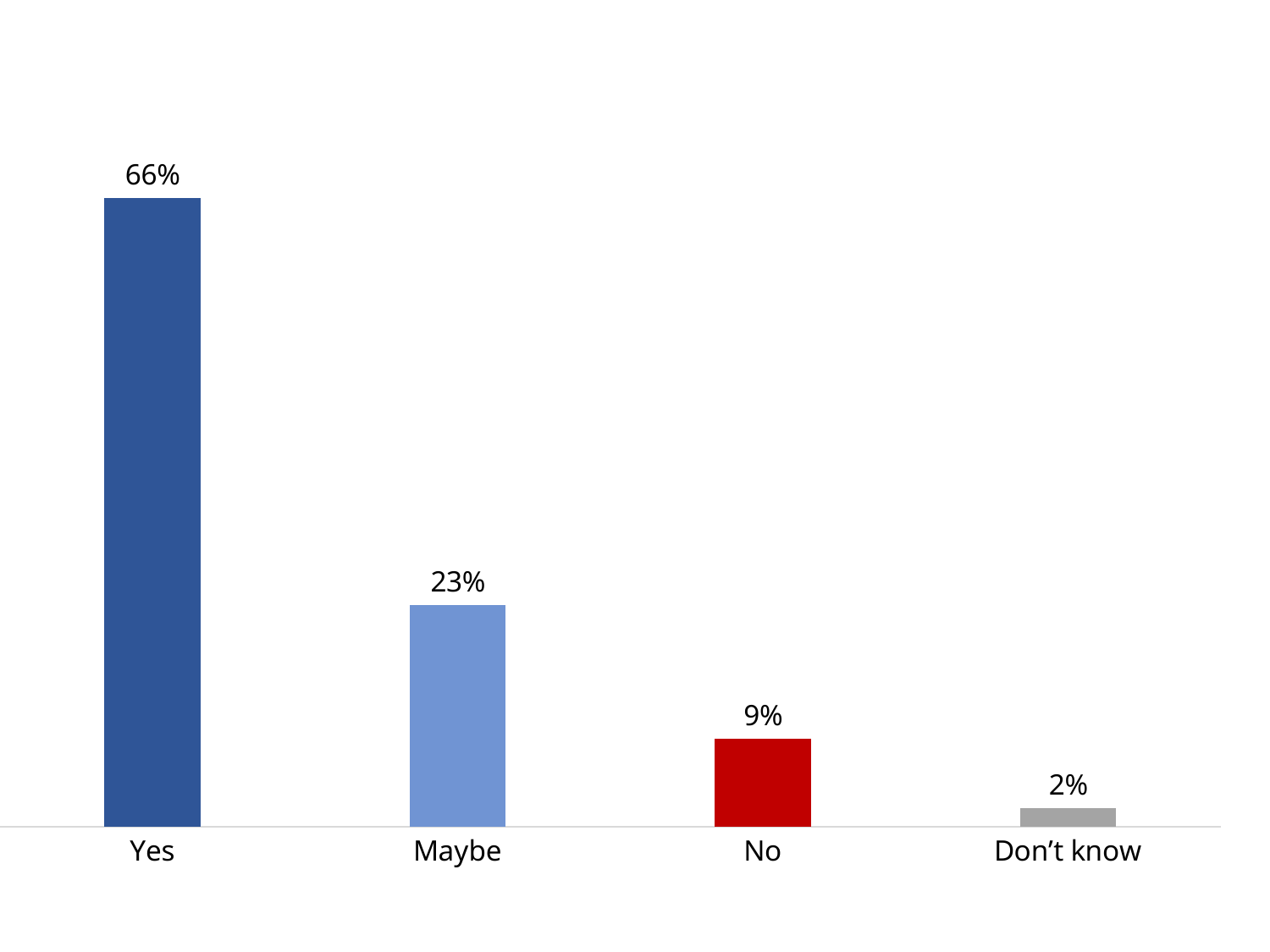
What is the difference between the values for No and Don't know? 7% What is the value for No? 9% Which category has the lowest value? Don't know Do the values rise or fall from left to right along the x axis? Fall What is the value for Don't know? 2% What is the difference between the values for Yes and Maybe? 43% What kind of chart is this? Bar chart What is the value for Maybe? 23% What is the value for Yes? 66% Which is larger, the value for Maybe or the value for No? Maybe Which category has the highest value? Yes How many categories are shown in the chart? 4